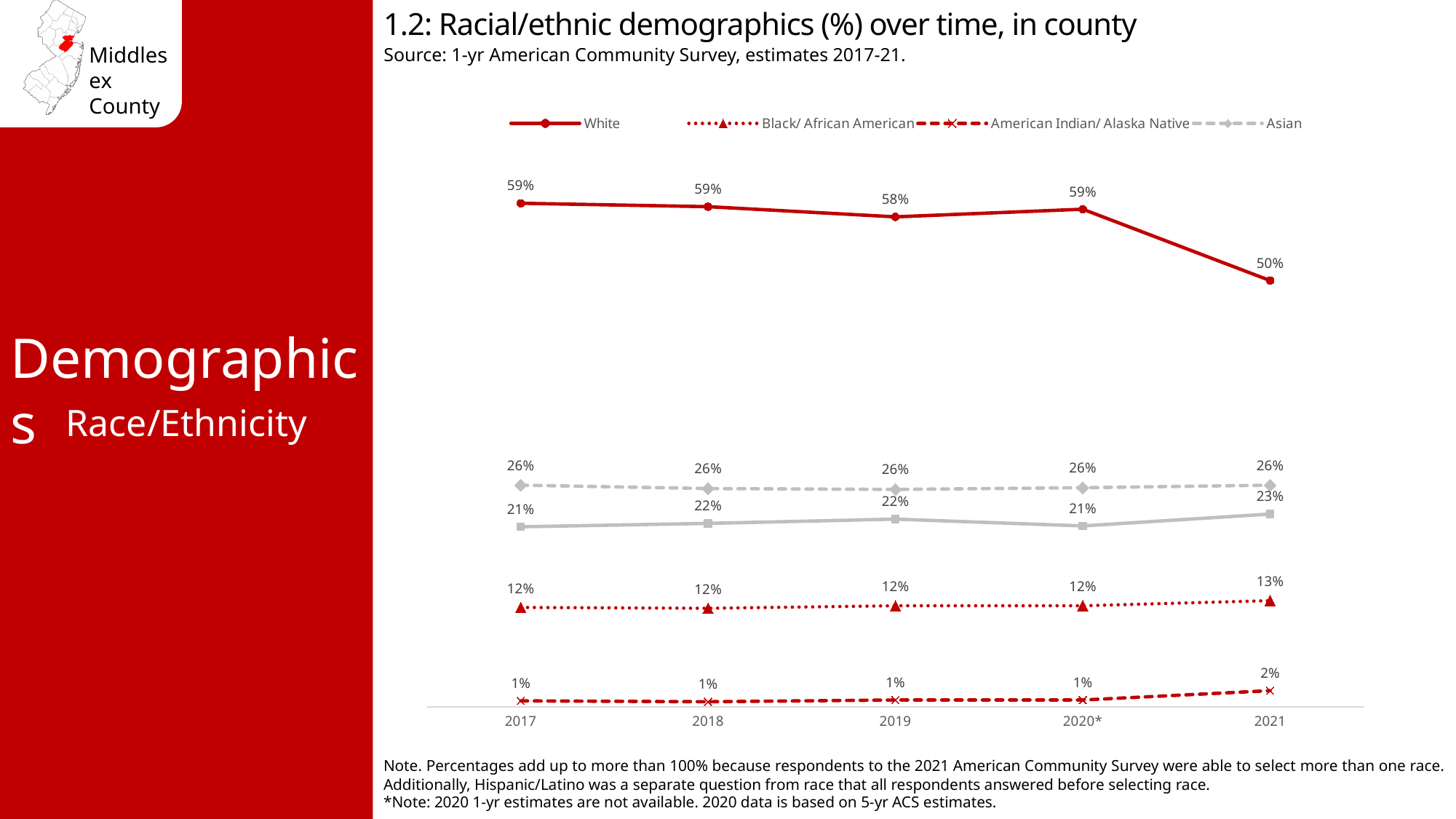
What was the American Indian/ Alaska Native percentage in 2021? 2% How many years are shown on the x axis? 5 Which series has the highest value in 2021, White or Asian? White Does the White percentage rise or fall between 2020* and 2021? fall In which year was the White percentage lowest? 2021 What was the Asian percentage in 2017? 26% What was the White percentage in 2019? 58% What kind of chart is shown on the slide? line chart What was the White percentage in 2021? 50% By how many percentage points did the White percentage fall from 2020* to 2021? 9 What was the Black/ African American percentage in 2021? 13% How many series does the legend list? 4